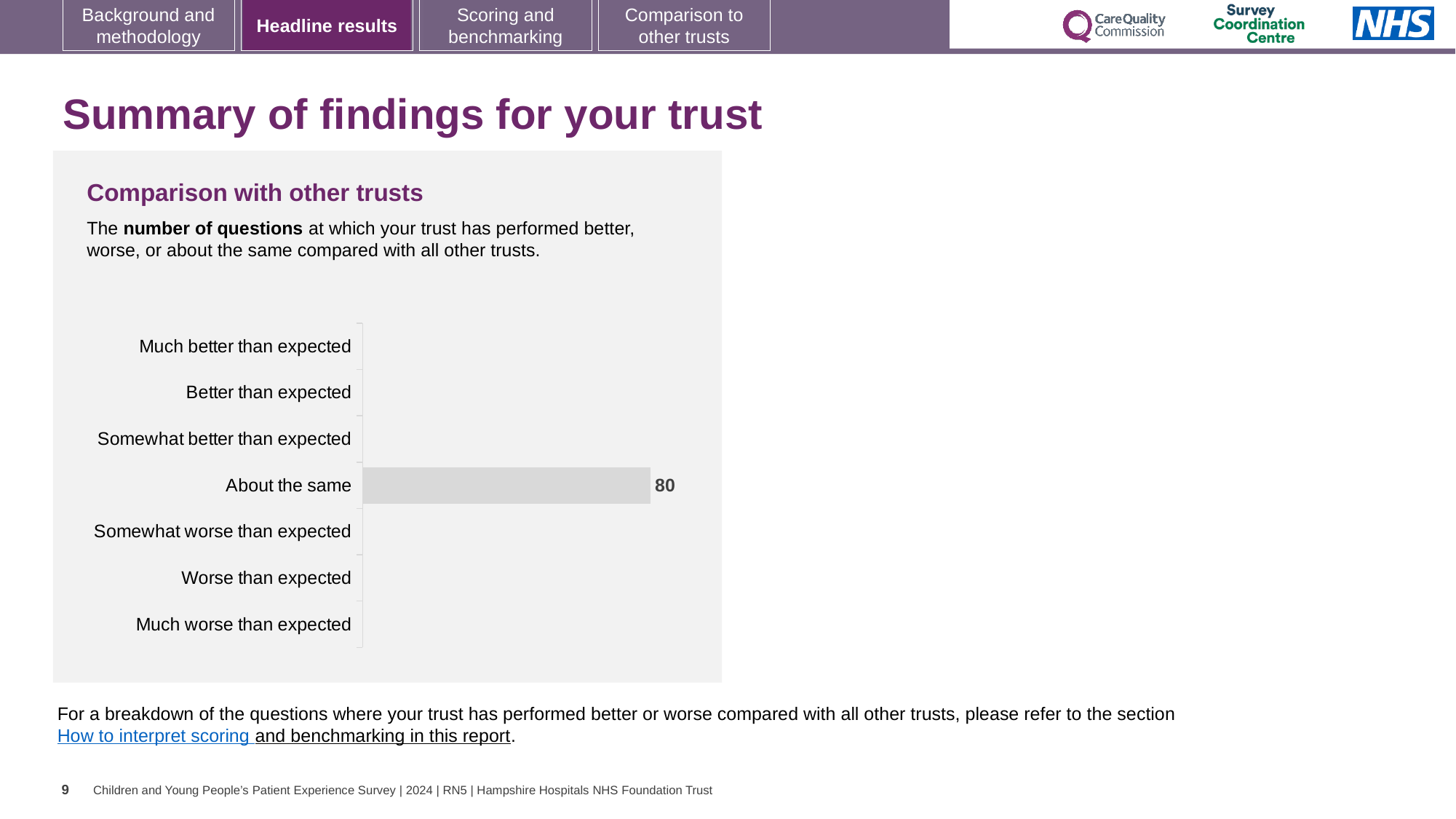
How many categories are listed on the chart's vertical axis? 7 How many categories have a visible bar on the chart? 1 What is the first category listed at the top of the chart? Much better than expected What is the value shown for 'About the same'? 80 Which is larger, the value for 'Somewhat worse than expected' or the value for 'About the same'? About the same What kind of chart is shown on the slide? bar chart What is the title of the chart? Comparison with other trusts Which category has the highest value on the chart? About the same Which category's bar is labelled with the number 80? About the same Which is larger, the value for 'About the same' or the value for 'Better than expected'? About the same